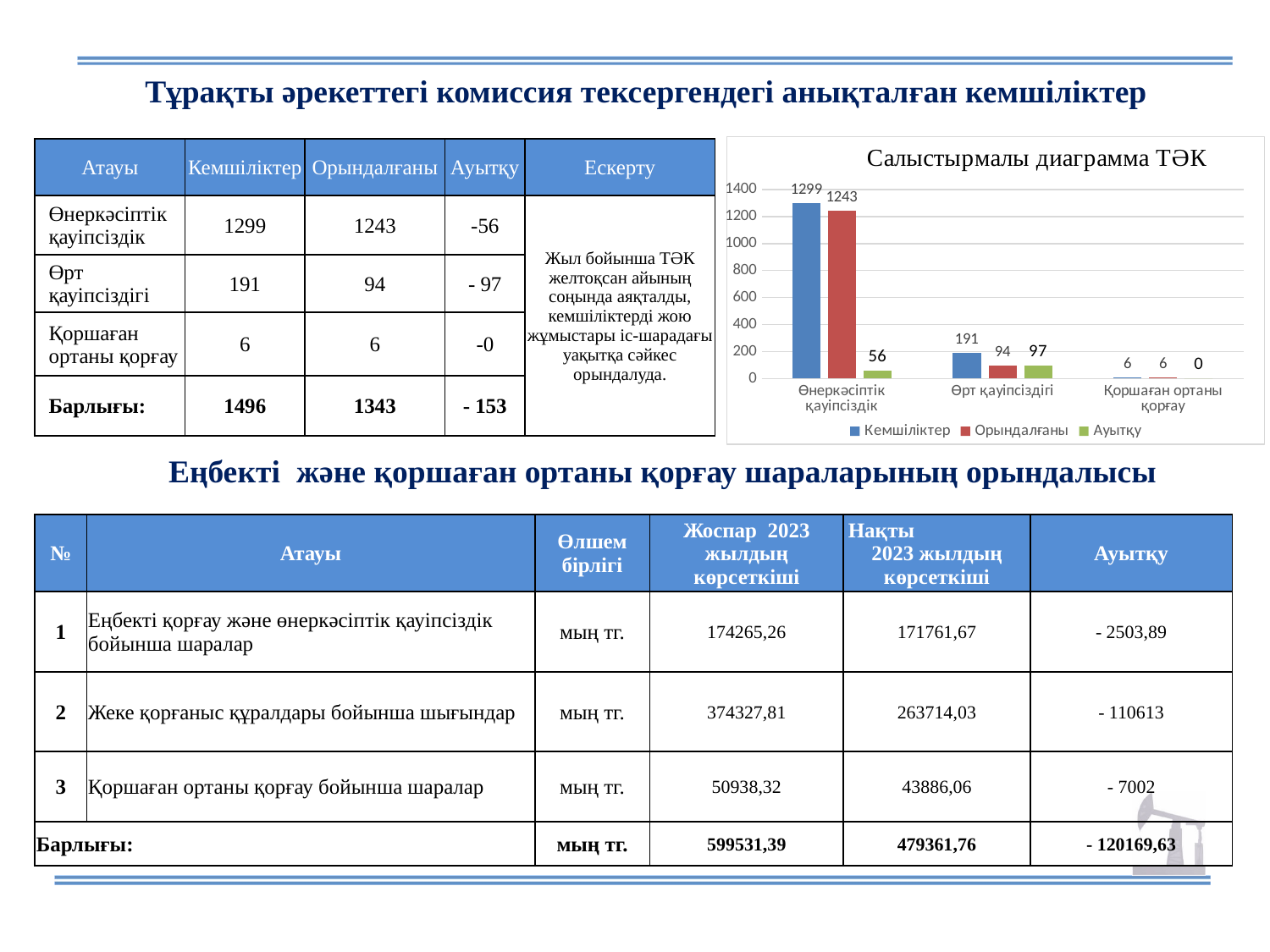
How many series does the chart legend list? 3 What is the value of Орындалғаны for Өнеркәсіптік қауіпсіздік? 1243 What is the difference between Кемшіліктер and Орындалғаны for Өрт қауіпсіздігі? 97 Which is larger for Өрт қауіпсіздігі: Кемшіліктер or Орындалғаны? Кемшіліктер Which category has the highest Кемшіліктер value? Өнеркәсіптік қауіпсіздік What kind of chart is shown on the slide? bar chart What is the value of Орындалғаны for Қоршаған ортаны қорғау? 6 What is the value of Ауытқу for Өрт қауіпсіздігі? 97 Which category has the lowest Орындалғаны value? Қоршаған ортаны қорғау How many categories are shown on the x axis of the chart? 3 What is the title of the chart? Салыстырмалы диаграмма ТӘК What is the value of Кемшіліктер for Өнеркәсіптік қауіпсіздік? 1299